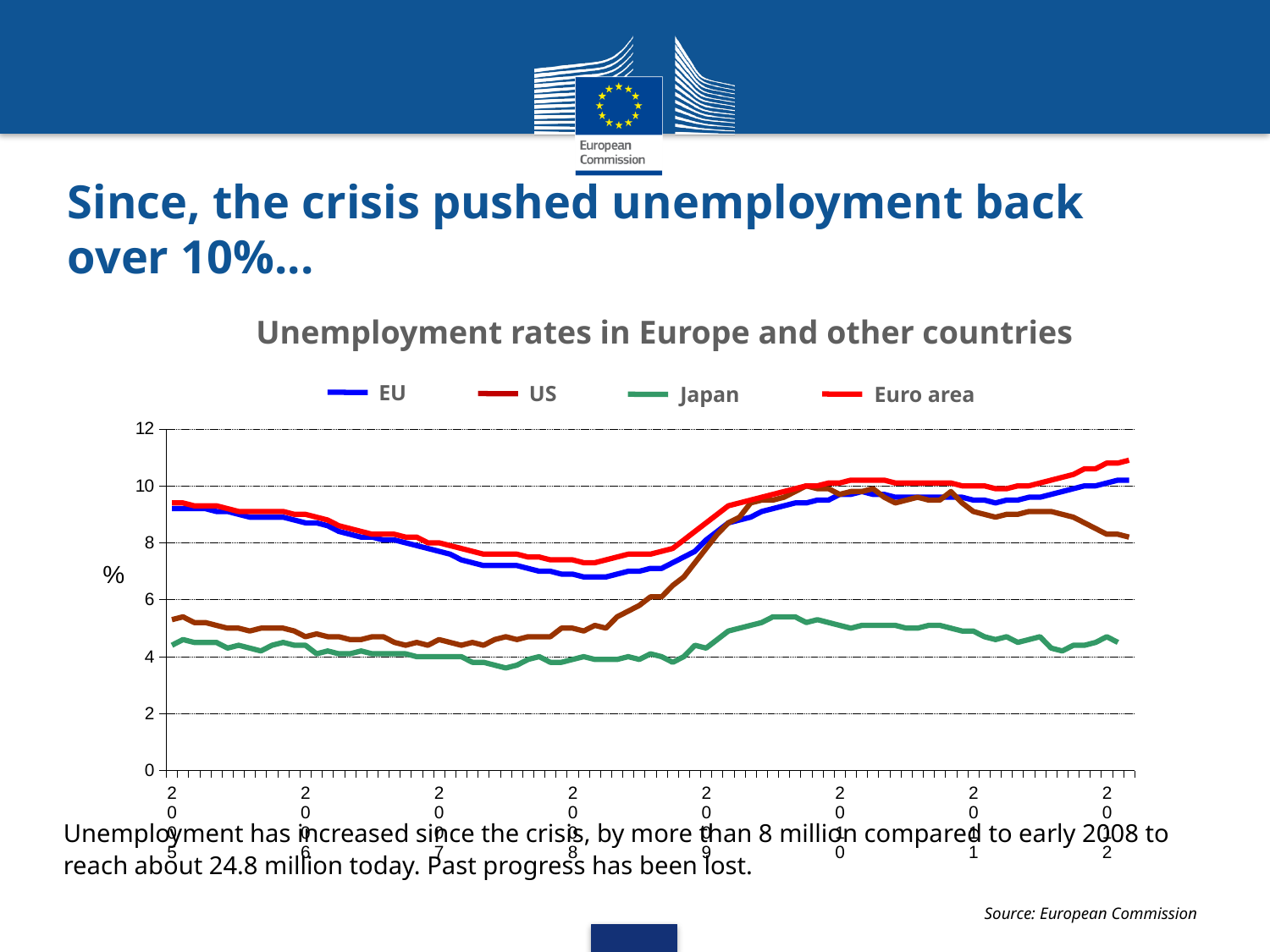
Is the value for the US at the start of the period (2005) greater or less than 6? less How many series does the legend list? 4 Does the US line rise or fall between 2008 and 2010? rise At the end of the period (2012), which is larger, the EU value or the US value? EU What is the title of the chart? Unemployment rates in Europe and other countries Which series has the lowest values across the whole period shown? Japan Is the value for Japan at the end of the period (2012) greater or less than 6? less Which colour is used for the Japan line? green Is the value for the Euro area at the end of the period (2012) greater or less than 10? greater What kind of chart is shown on the slide? line chart Which series has the highest value at the end of the period (2012)? Euro area Does the EU line rise or fall between 2005 and 2008? fall